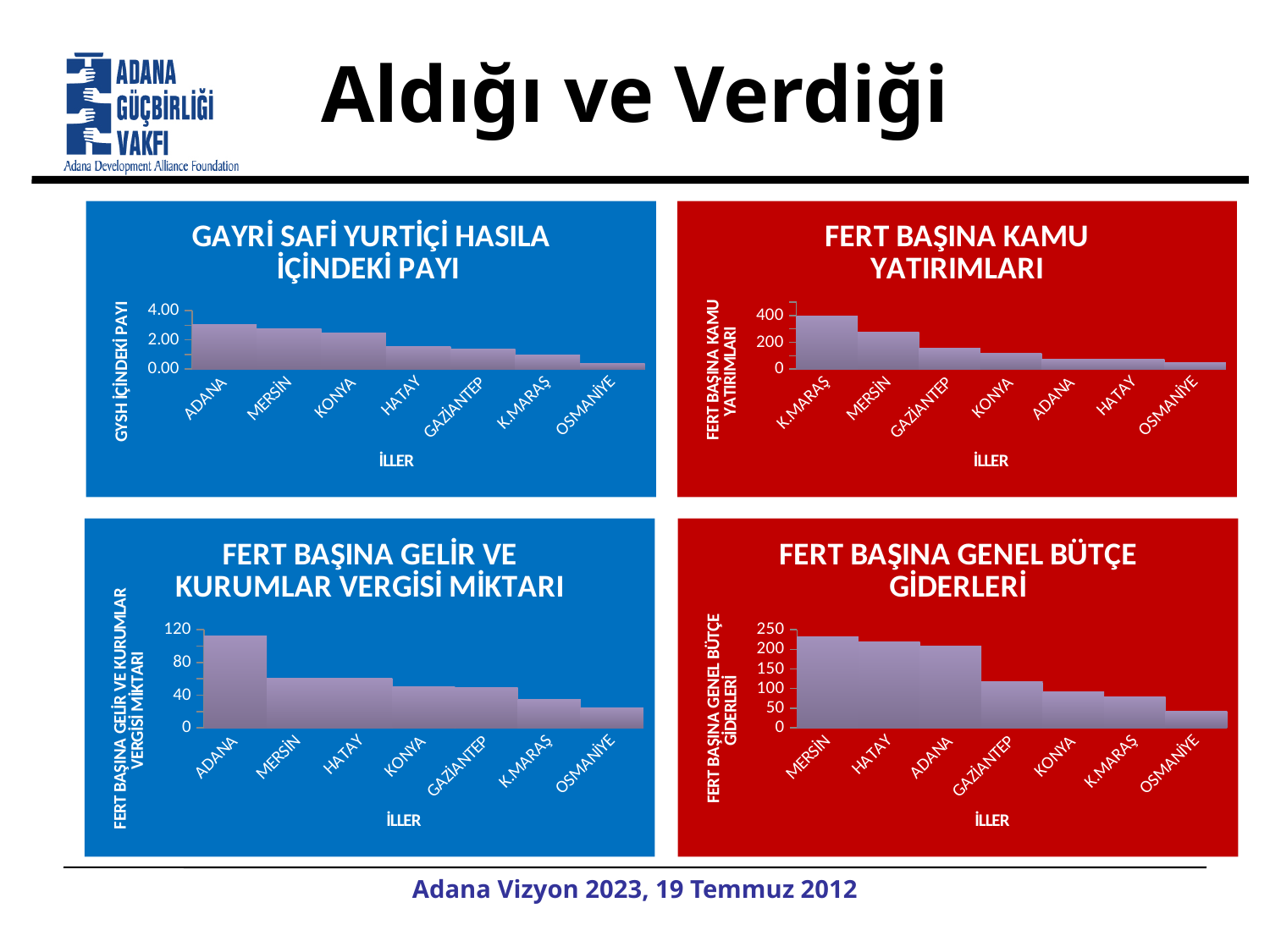
In the chart titled 'FERT BAŞINA KAMU YATIRIMLARI', which province has the highest value? K.MARAŞ In the chart titled 'FERT BAŞINA GENEL BÜTÇE GİDERLERİ', do the values rise or fall from left to right along the x axis? fall In the chart titled 'GAYRİ SAFİ YURTİÇİ HASILA İÇİNDEKİ PAYI', which province has the highest value? ADANA In the chart titled 'FERT BAŞINA KAMU YATIRIMLARI', is the value for KONYA greater or less than 200? less What type of chart is the chart titled 'FERT BAŞINA GENEL BÜTÇE GİDERLERİ'? bar chart In the chart titled 'FERT BAŞINA GELİR VE KURUMLAR VERGİSİ MİKTARI', is the value for ADANA greater or less than 80? greater In the chart titled 'FERT BAŞINA KAMU YATIRIMLARI', which province has the lowest value? OSMANİYE In the chart titled 'FERT BAŞINA GENEL BÜTÇE GİDERLERİ', is the value for KONYA greater or less than 100? less In the chart titled 'FERT BAŞINA GENEL BÜTÇE GİDERLERİ', which province has the highest value? MERSİN In the chart titled 'FERT BAŞINA GELİR VE KURUMLAR VERGİSİ MİKTARI', which is larger, the value for MERSİN or the value for K.MARAŞ? MERSİN In the chart titled 'GAYRİ SAFİ YURTİÇİ HASILA İÇİNDEKİ PAYI', how many provinces are shown on the x axis? 7